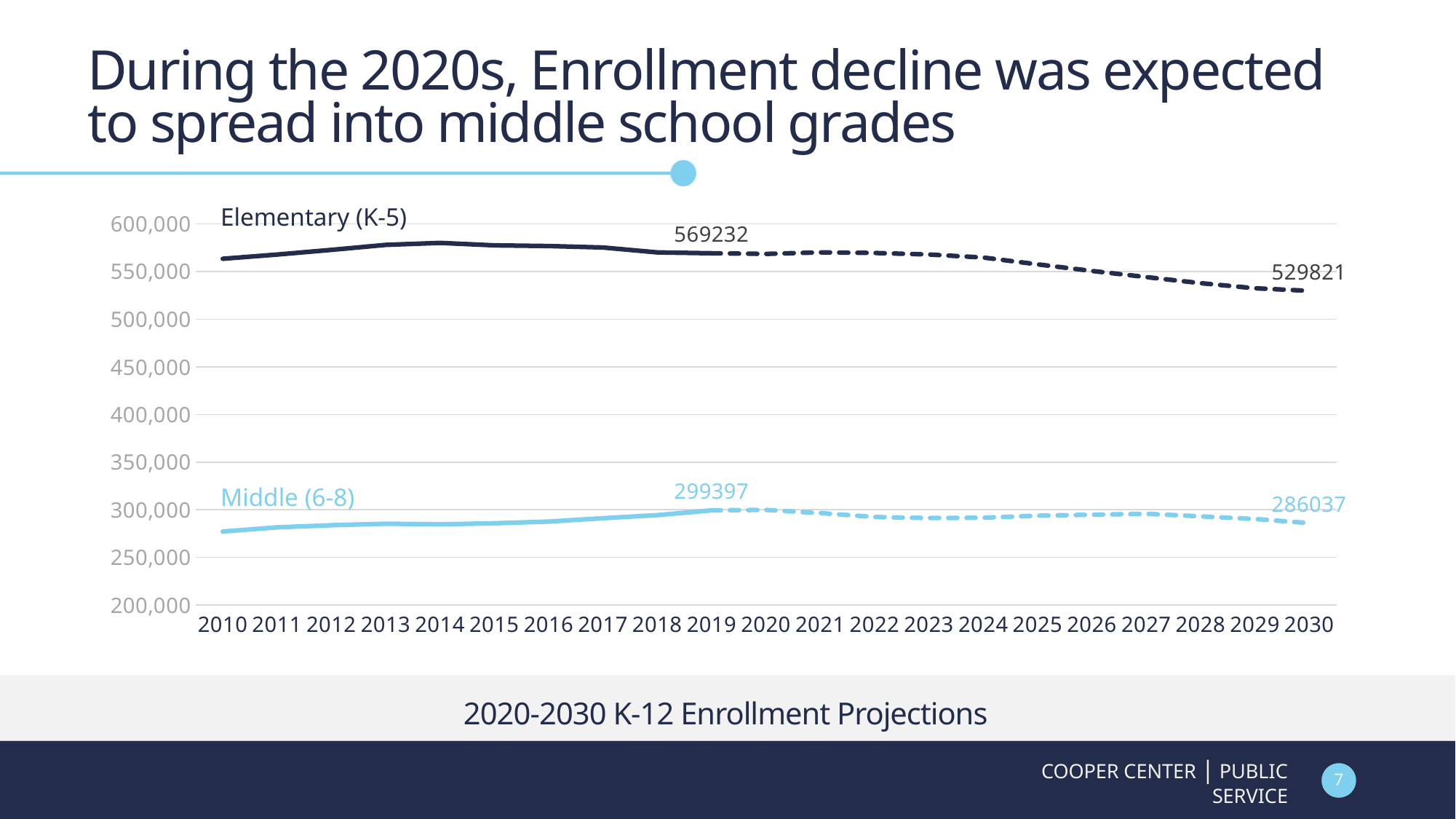
Which is larger: the Elementary (K-5) value for 2019 or for 2030? 2019 What is the projected Middle (6-8) enrollment labeled for 2030? 286037 What is the Middle (6-8) enrollment value labeled for 2019? 299397 What is the Elementary (K-5) enrollment value labeled for 2019? 569232 What is the projected Elementary (K-5) enrollment labeled for 2030? 529821 How many years are shown on the x axis? 21 What is the title shown beneath the chart? 2020-2030 K-12 Enrollment Projections What is the difference between the Middle (6-8) values labeled for 2019 and 2030? 13360 Is the Elementary (K-5) value for 2014 greater or less than 550,000? greater Is the Middle (6-8) value for 2010 greater or less than 300,000? less What kind of chart is shown on the slide? line chart By how much is Elementary (K-5) enrollment projected to fall from 2019 to 2030? 39411